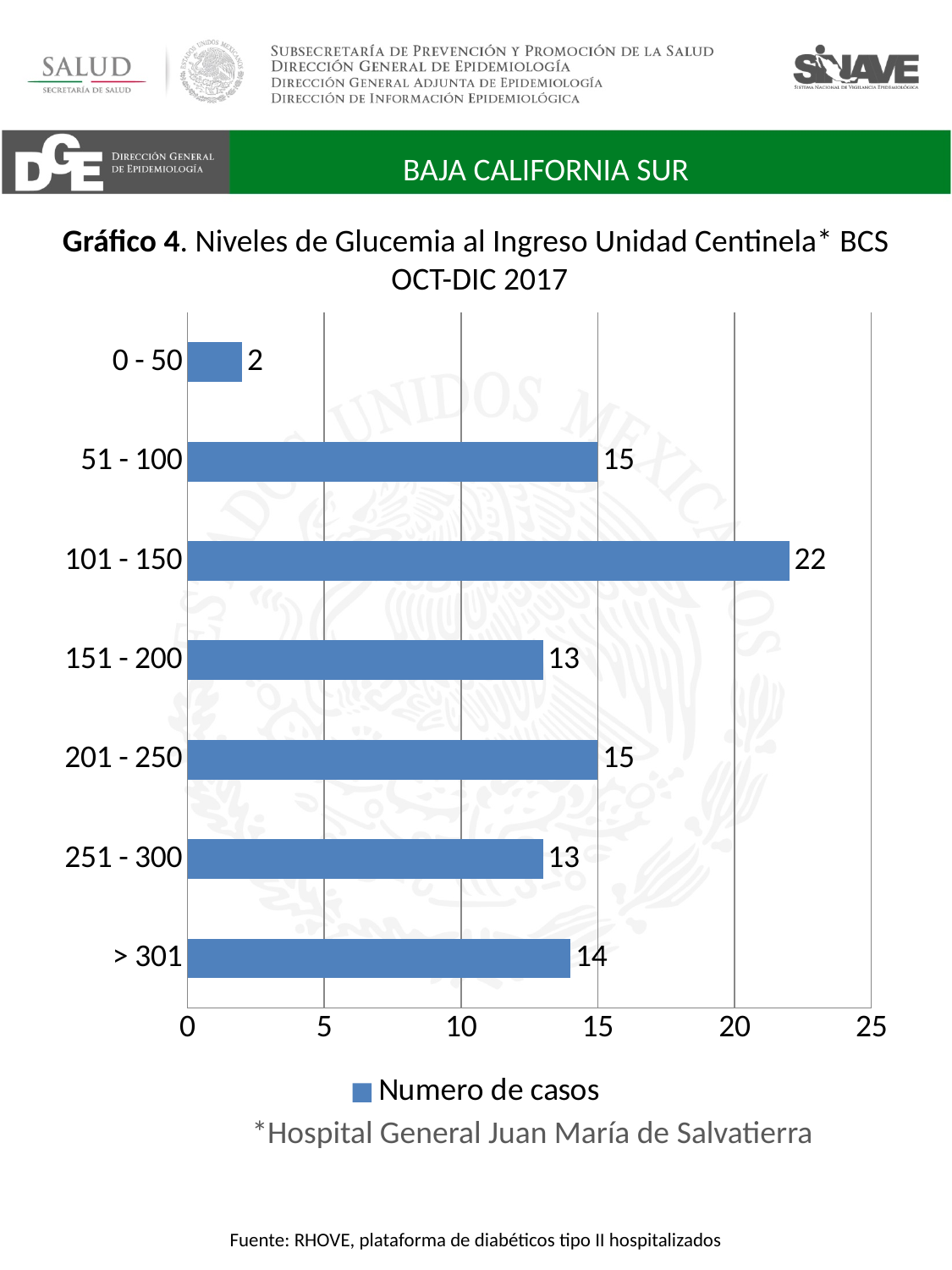
What is the number of cases for the 101 - 150 glucose level category? 22 How many glucose level categories are shown in the chart? 7 What is the number of cases for the 0 - 50 category? 2 Which has more cases, the 51 - 100 category or the > 301 category? 51 - 100 How many series does the legend list? 1 What is the legend entry for the series in the chart? Numero de casos What is the number of cases for the > 301 category? 14 What kind of chart is shown on the slide? Bar chart Which glucose level category has the lowest number of cases? 0 - 50 Which glucose level category has the highest number of cases? 101 - 150 Is the value for the 251 - 300 category greater or less than 15? less What is the difference in number of cases between the 101 - 150 and 151 - 200 categories? 9